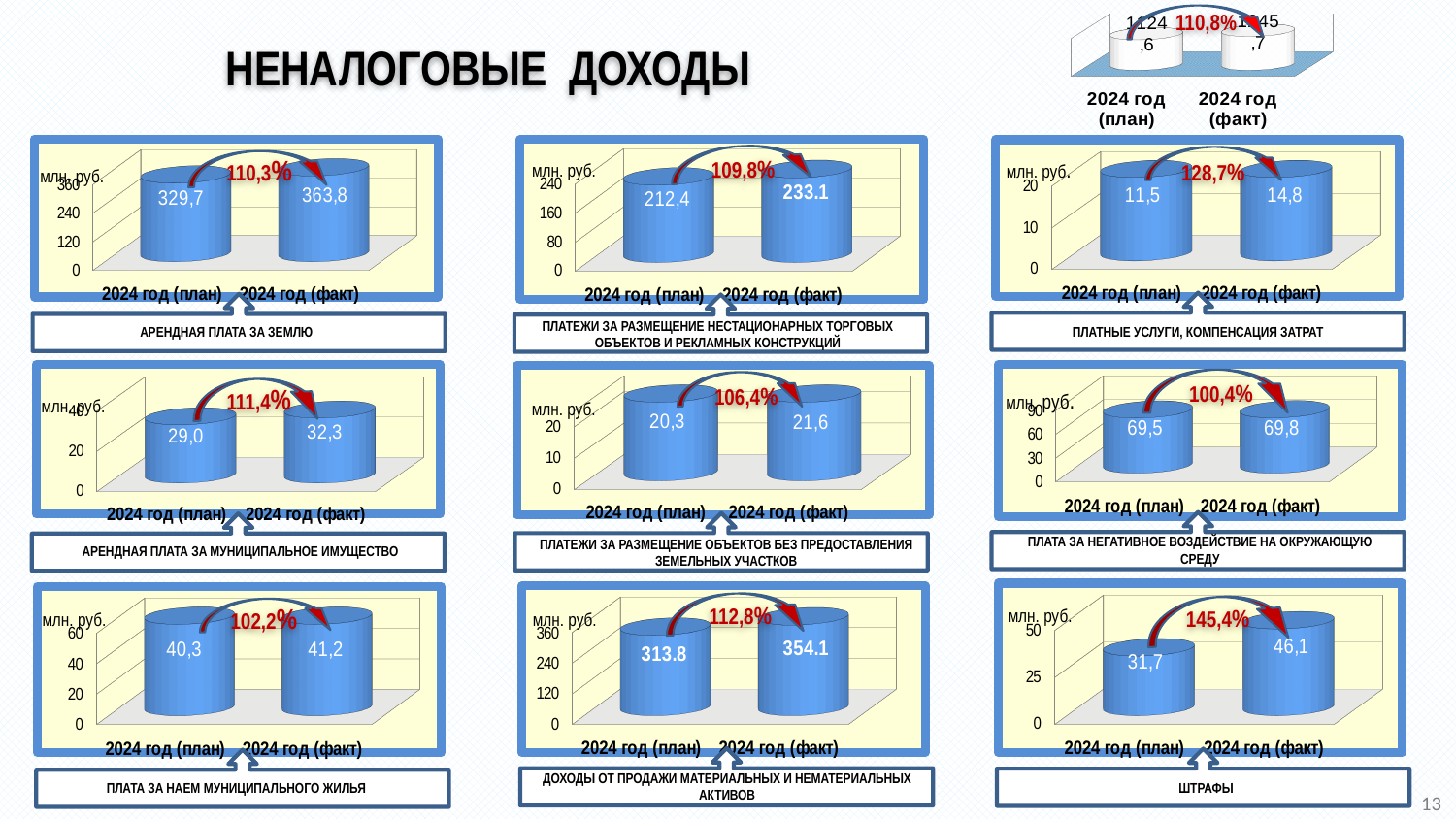
In the chart captioned «АРЕНДНАЯ ПЛАТА ЗА ЗЕМЛЮ», what is the difference between the 2024 год (факт) and 2024 год (план) values? 34,1 In the chart captioned «ПЛАТНЫЕ УСЛУГИ, КОМПЕНСАЦИЯ ЗАТРАТ», which is larger, 2024 год (план) or 2024 год (факт)? 2024 год (факт) In the chart captioned «ШТРАФЫ», what is the difference between the 2024 год (факт) and 2024 год (план) values? 14,4 How many categories are plotted in the chart captioned «ПЛАТА ЗА НАЕМ МУНИЦИПАЛЬНОГО ЖИЛЬЯ»? 2 In the chart captioned «АРЕНДНАЯ ПЛАТА ЗА ЗЕМЛЮ», what is the value for 2024 год (факт)? 363,8 In the chart captioned «ШТРАФЫ», what is the value for 2024 год (план)? 31,7 What type of chart is used in the chart captioned «ПЛАТЕЖИ ЗА РАЗМЕЩЕНИЕ ОБЪЕКТОВ БЕЗ ПРЕДОСТАВЛЕНИЯ ЗЕМЕЛЬНЫХ УЧАСТКОВ»? Bar chart What percentage is shown above the bars in the chart captioned «ПЛАТА ЗА НЕГАТИВНОЕ ВОЗДЕЙСТВИЕ НА ОКРУЖАЮЩУЮ СРЕДУ»? 100,4% In the chart captioned «АРЕНДНАЯ ПЛАТА ЗА МУНИЦИПАЛЬНОЕ ИМУЩЕСТВО», which category has the lowest value? 2024 год (план) In the chart captioned «ПЛАТНЫЕ УСЛУГИ, КОМПЕНСАЦИЯ ЗАТРАТ», what is the value for 2024 год (факт)? 14,8 In the chart captioned «ДОХОДЫ ОТ ПРОДАЖИ МАТЕРИАЛЬНЫХ И НЕМАТЕРИАЛЬНЫХ АКТИВОВ», what is the value for 2024 год (план)? 313.8 In the chart captioned «ШТРАФЫ», which category has the highest value? 2024 год (факт)